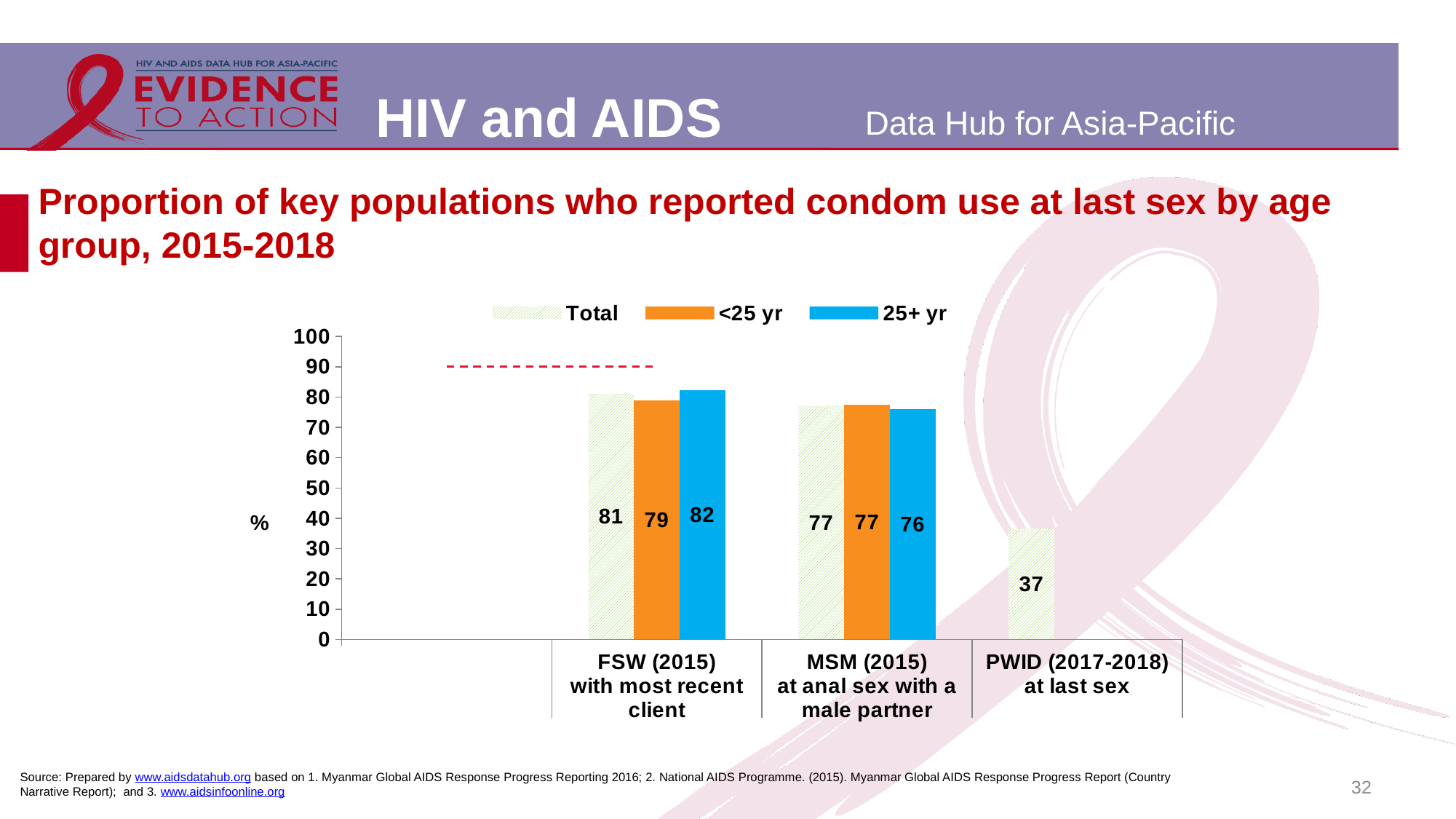
What is the Total value for PWID (2017-2018) at last sex? 37 What is the 25+ yr value for FSW (2015) with most recent client? 82 What is the difference between the 25+ yr value for FSW (2015) and the 25+ yr value for MSM (2015)? 6 Which series is shown in orange in the legend? <25 yr How many key population categories are shown on the x axis? 3 How many series does the legend list? 3 Which is larger for FSW (2015): the <25 yr value or the 25+ yr value? 25+ yr Which key population has the lowest Total value? PWID (2017-2018) at last sex Which key population has the highest Total value? FSW (2015) with most recent client What type of chart is shown on the slide? Bar chart What is the Total value for FSW (2015) with most recent client? 81 What is the <25 yr value for MSM (2015) at anal sex with a male partner? 77